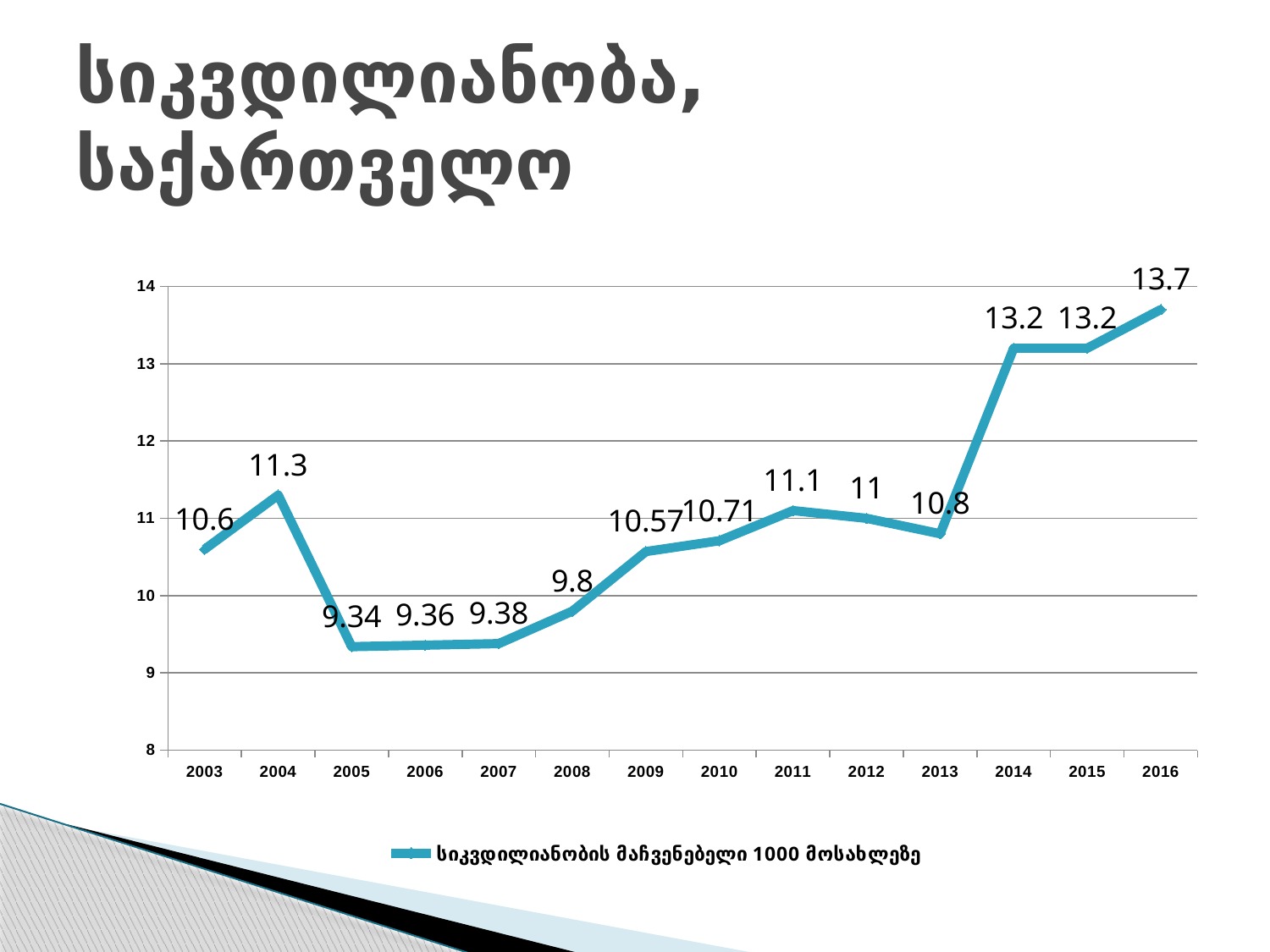
Which year has the lowest value? 2005 Do the values rise or fall from 2013 to 2016? rise Which is larger, the value for 2004 or the value for 2011? 2004 How many years are plotted on the x axis? 14 Is the value for 2014 greater or less than 13? greater What type of chart is shown on the slide? line chart What is the value for 2016? 13.7 Which year has the highest value? 2016 What is the value for 2009? 10.57 How many series does the legend list? 1 What is the difference between the values for 2016 and 2003? 3.1 What is the value for 2003? 10.6